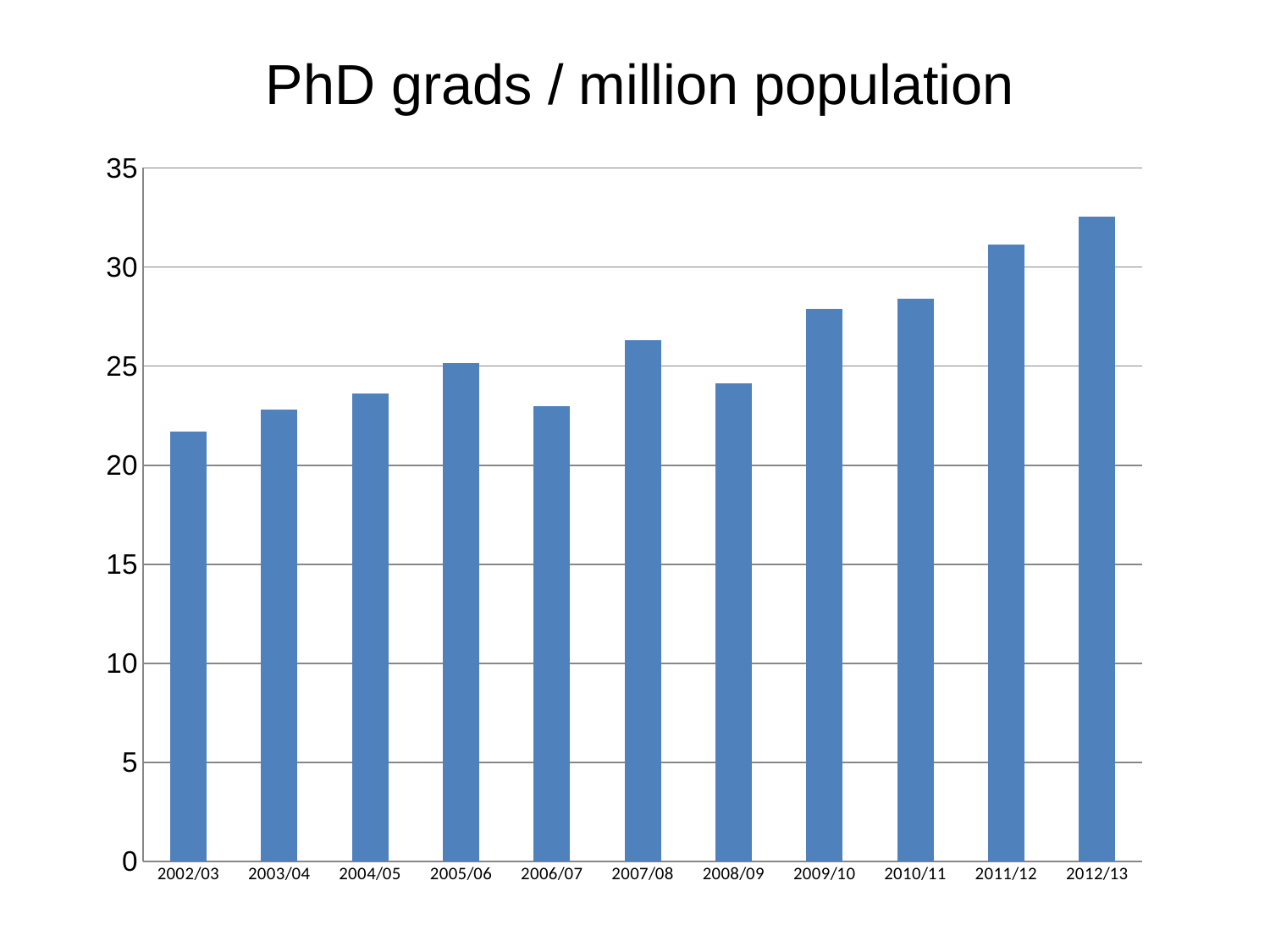
Is the value for 2007/08 greater or less than 25? greater Overall, do the values rise or fall from 2002/03 to 2012/13? Rise Which year has the highest value? 2012/13 What is the title of the chart? PhD grads / million population Is the value for 2002/03 greater or less than 25? less Is the value for 2012/13 greater or less than 30? greater Which year has the lowest value? 2002/03 Which is larger, the value for 2007/08 or the value for 2006/07? 2007/08 What kind of chart is shown on the slide? Bar chart Which is larger, the value for 2009/10 or the value for 2008/09? 2009/10 How many academic years are shown on the x axis? 11